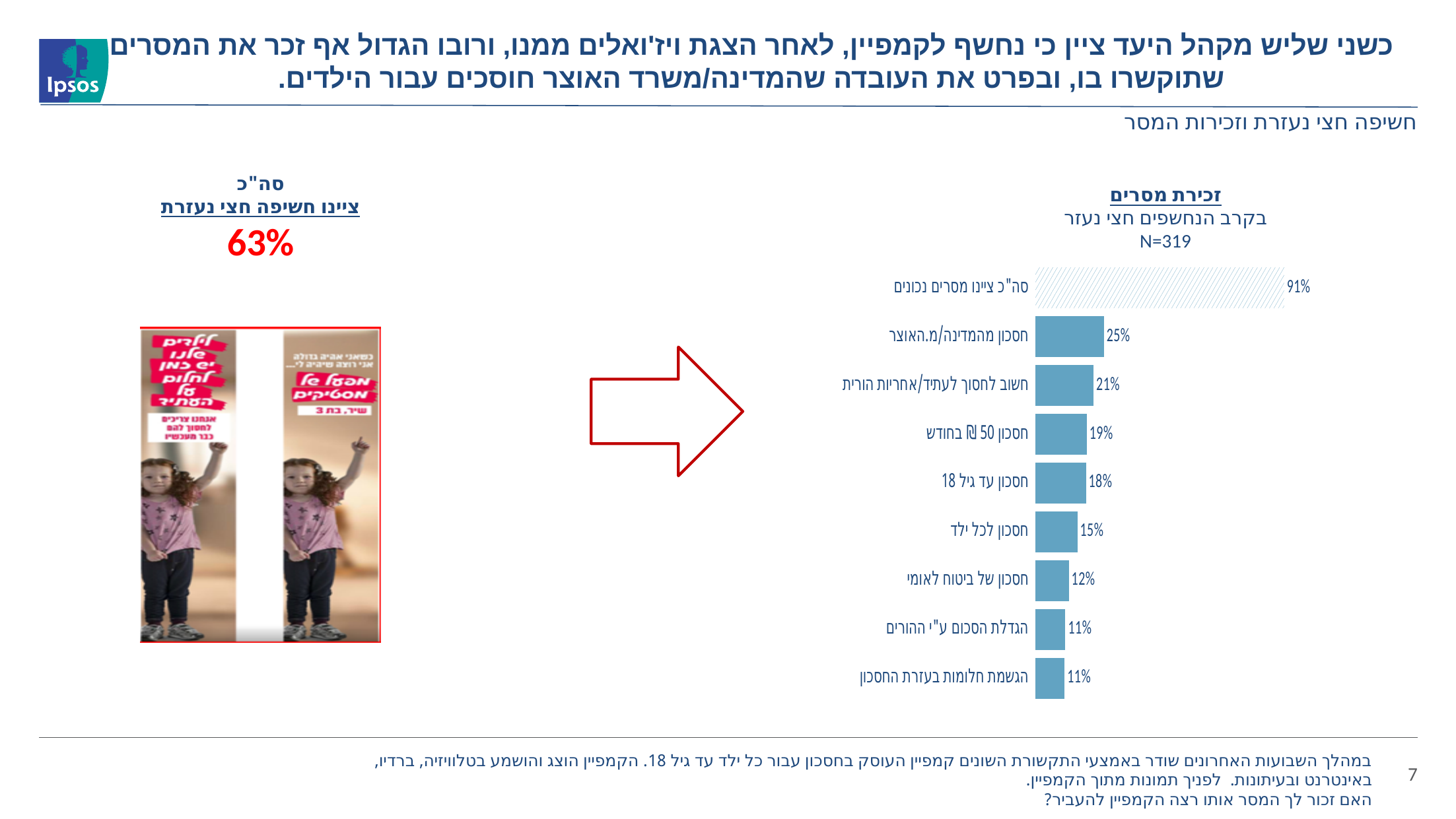
How many categories are shown in the bar chart? 9 What is the value for "חסכון של ביטוח לאומי"? 12% What is the sample size (N) shown above the chart? N=319 What is the value for "סה"כ ציינו מסרים נכונים"? 91% Excluding the total row "סה"כ ציינו מסרים נכונים", which specific message has the highest value? חסכון מהמדינה/מ.האוצר What is the title of the bar chart? זכירת מסרים What type of chart is shown on the slide? bar chart Which is larger: "חסכון עד גיל 18" or "חסכון לכל ילד"? חסכון עד גיל 18 Which category has the highest value in the chart? סה"כ ציינו מסרים נכונים What is the difference between "חסכון מהמדינה/מ.האוצר" and "חשוב לחסוך לעתיד/אחריות הורית"? 4% What is the value for "חסכון 50 ₪ בחודש"? 19% What is the value for "חסכון מהמדינה/מ.האוצר"? 25%